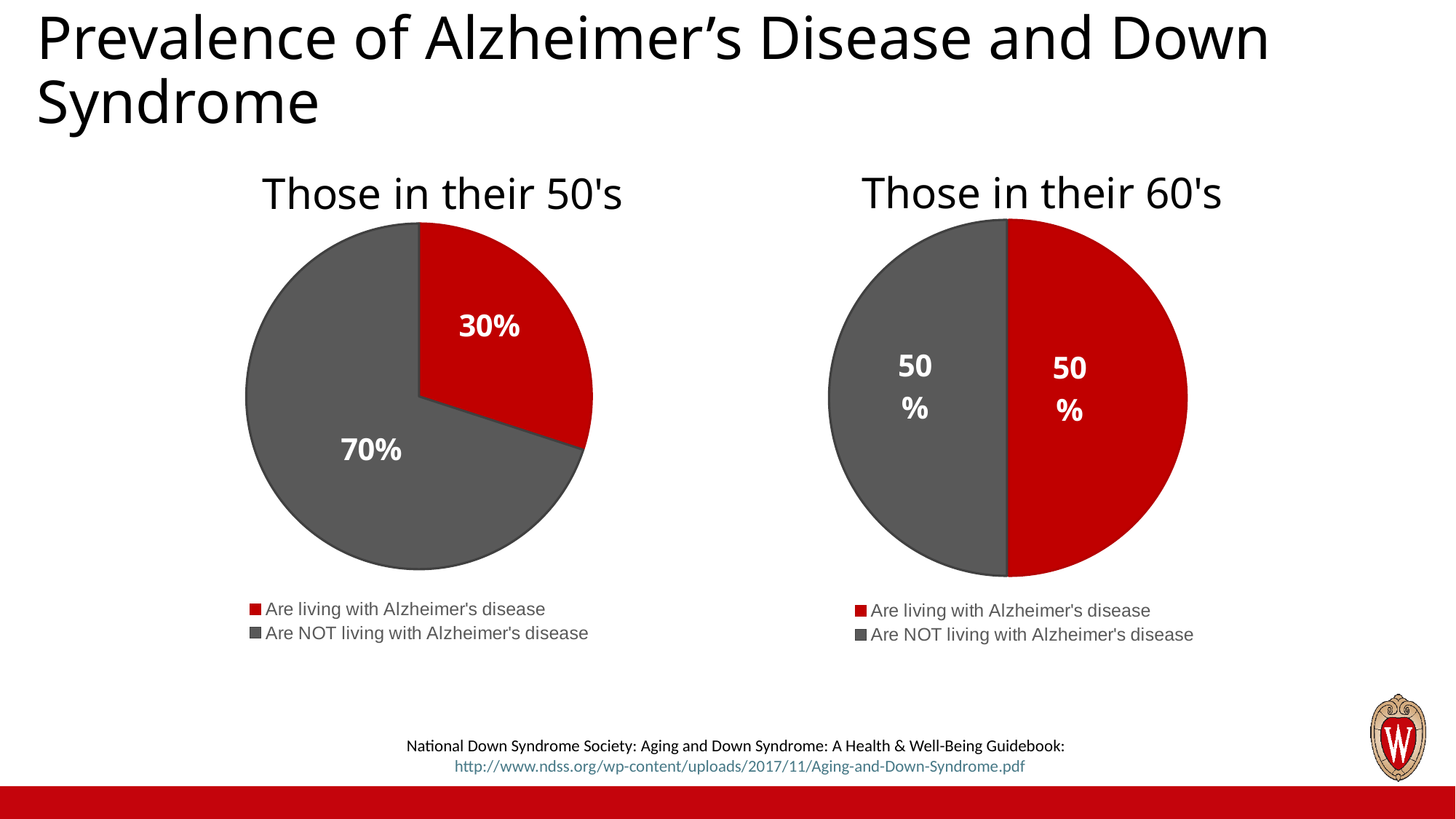
How many entries does the legend of the 'Those in their 60's' chart list? 2 In the 'Those in their 50's' chart, what share of the pie is 'Are living with Alzheimer's disease'? 30% In the 'Those in their 50's' chart, what share of the pie is 'Are NOT living with Alzheimer's disease'? 70% In the 'Those in their 50's' chart, what colour is the 'Are living with Alzheimer's disease' slice? Red In the 'Those in their 50's' chart, what is the difference between the 'Are NOT living with Alzheimer's disease' slice and the 'Are living with Alzheimer's disease' slice? 40% What kind of chart is 'Those in their 60's'? Pie chart In the 'Those in their 50's' chart, which is larger: 'Are living with Alzheimer's disease' or 'Are NOT living with Alzheimer's disease'? Are NOT living with Alzheimer's disease In the 'Those in their 50's' chart, which slice is the smallest? Are living with Alzheimer's disease In the 'Those in their 60's' chart, what share of the pie is 'Are living with Alzheimer's disease'? 50% How many slices does the 'Those in their 50's' chart have? 2 In the 'Those in their 50's' chart, which slice is the largest? Are NOT living with Alzheimer's disease